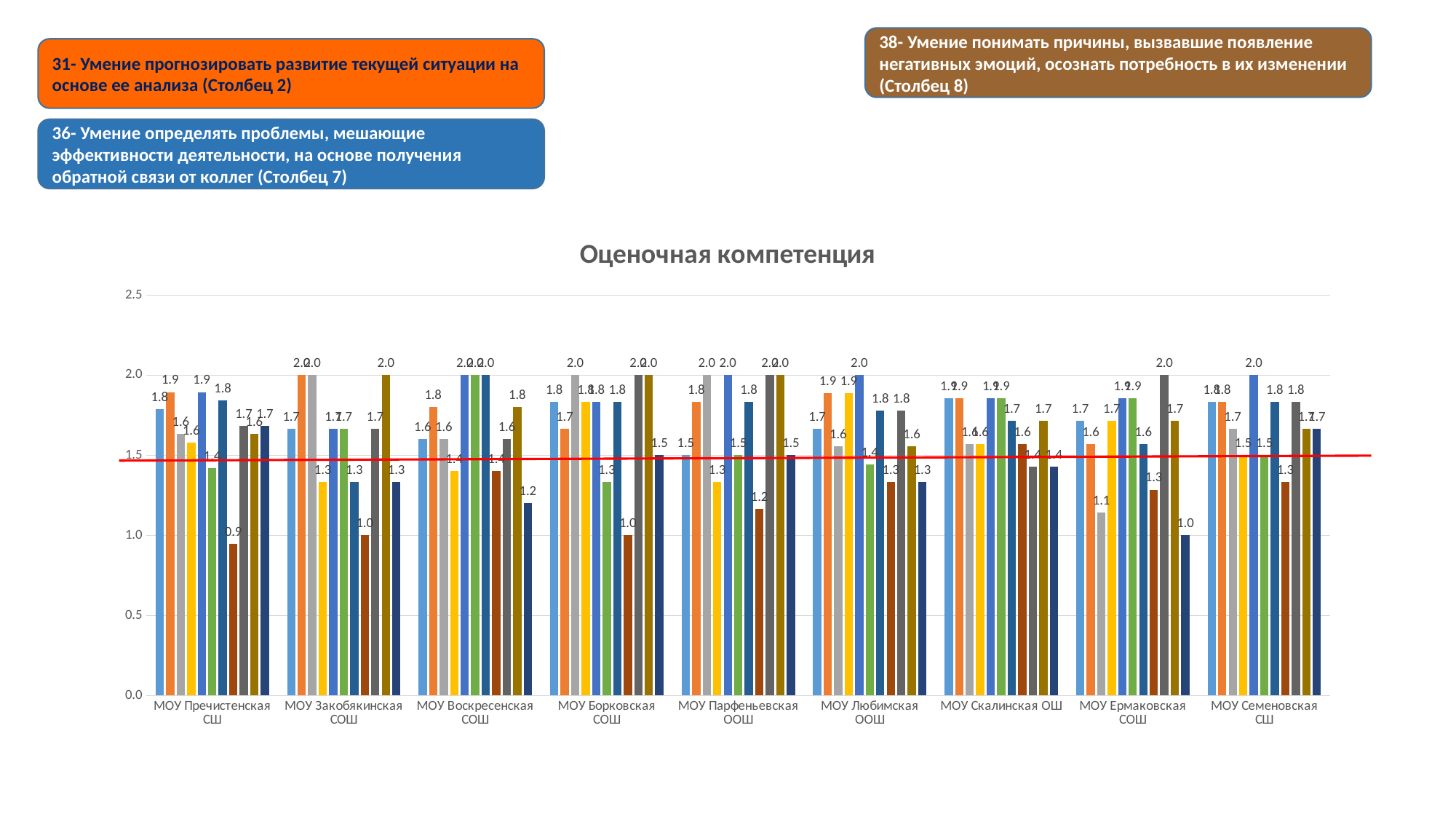
How many schools (categories) are shown on the x axis of the chart? 9 What kind of chart is shown under the title "Оценочная компетенция"? bar chart For which school is the brown bar the lowest? МОУ Пречистенская СШ What colour is the horizontal reference line drawn across the chart? red How many bars are plotted for each school in the chart? 11 Is the brown bar for МОУ Борковская СОШ greater or less than 1.5? less What is the value of the orange bar for МОУ Ермаковская СОШ? 1.6 For МОУ Закобякинская СОШ, which is larger: the orange bar or the brown bar? the orange bar What is the difference between the orange bar (1.9) and the brown bar (0.9) for МОУ Пречистенская СШ? 1.0 What is the value of the brown bar for МОУ Пречистенская СШ? 0.9 What is the value of the orange bar for МОУ Пречистенская СШ? 1.9 What is the lowest value labelled anywhere in the chart? 0.9